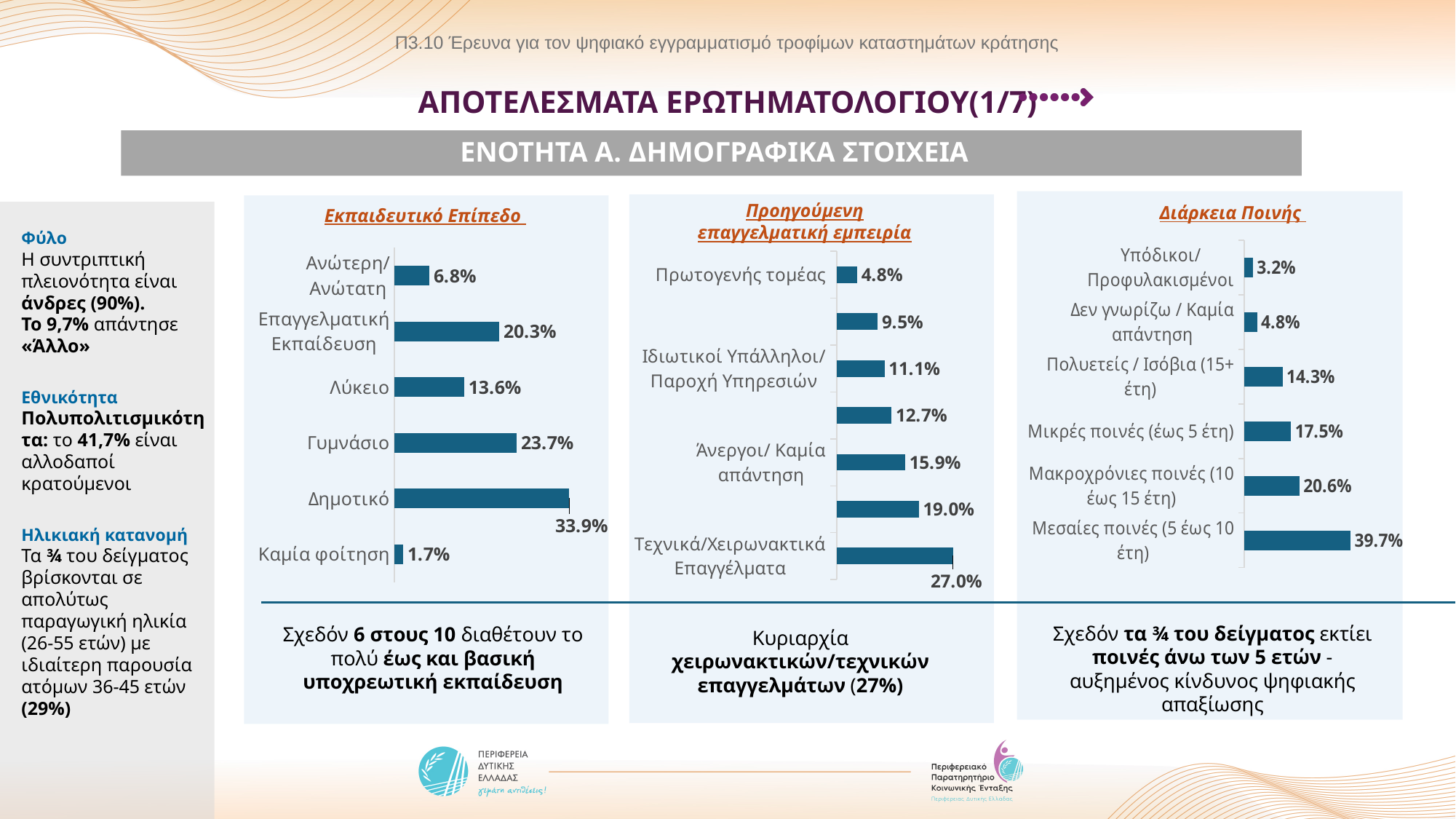
In the 'Εκπαιδευτικό Επίπεδο' chart, what is the value for Δημοτικό? 33.9% In the 'Διάρκεια Ποινής' chart, which category has the highest value? Μεσαίες ποινές (5 έως 10 έτη) In the 'Διάρκεια Ποινής' chart, what is the difference between Μικρές ποινές (έως 5 έτη) and Πολυετείς / Ισόβια (15+ έτη)? 3.2% In the 'Προηγούμενη επαγγελματική εμπειρία' chart, how many bars are plotted? 7 What type of chart is the 'Διάρκεια Ποινής' chart? Bar chart In the 'Εκπαιδευτικό Επίπεδο' chart, which category has the lowest value? Καμία φοίτηση In the 'Εκπαιδευτικό Επίπεδο' chart, what is the difference between Γυμνάσιο and Λύκειο? 10.1% In the 'Προηγούμενη επαγγελματική εμπειρία' chart, which is larger: Πρωτογενής τομέας or Άνεργοι/Καμία απάντηση? Άνεργοι/Καμία απάντηση In the 'Διάρκεια Ποινής' chart, what is the value for Μακροχρόνιες ποινές (10 έως 15 έτη)? 20.6% In the 'Εκπαιδευτικό Επίπεδο' chart, how many categories are shown? 6 In the 'Προηγούμενη επαγγελματική εμπειρία' chart, what is the value for Τεχνικά/Χειρωνακτικά Επαγγέλματα? 27.0% In the 'Προηγούμενη επαγγελματική εμπειρία' chart, which category has the highest value? Τεχνικά/Χειρωνακτικά Επαγγέλματα